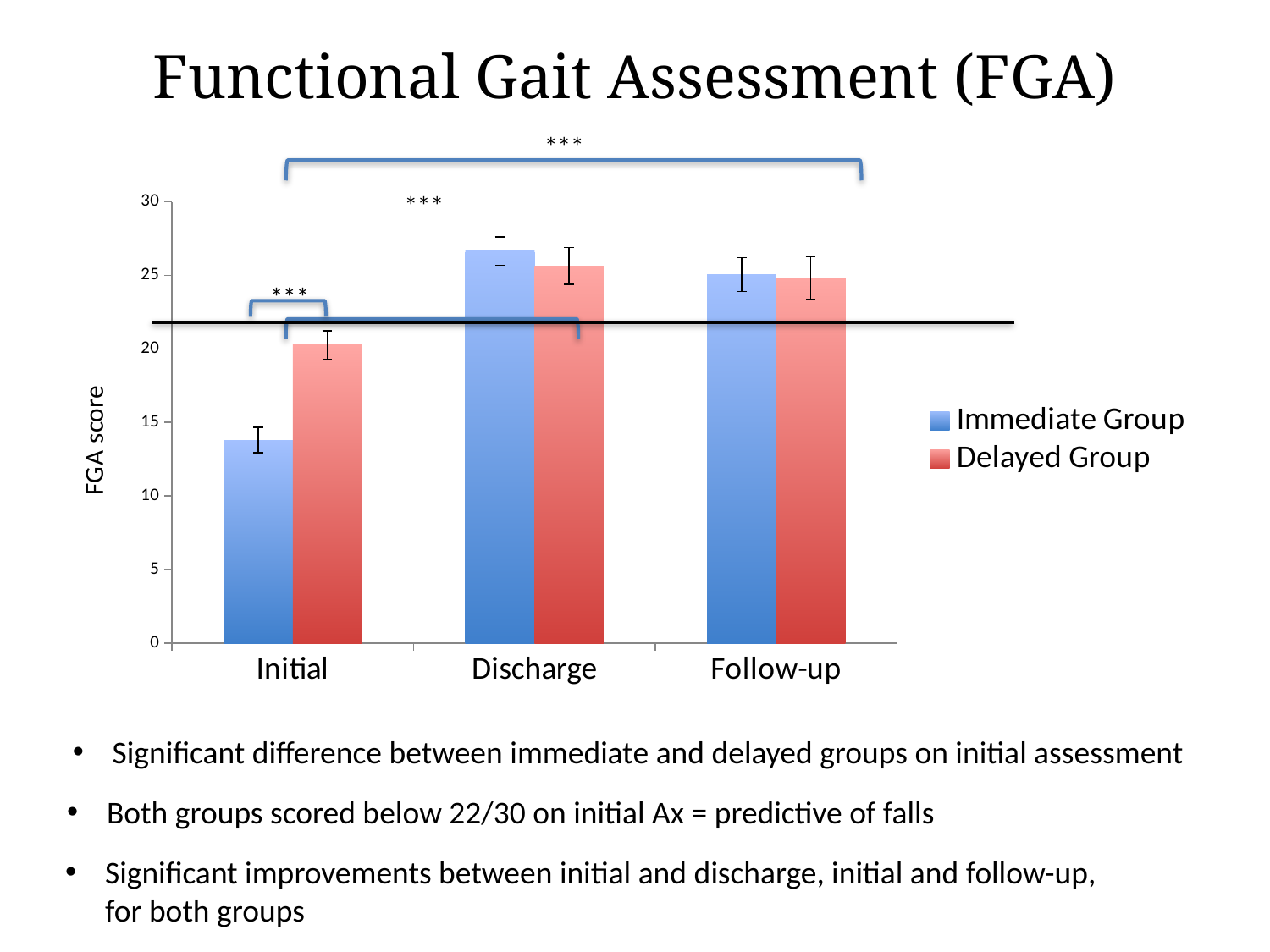
How many series does the legend list? 2 At which time point is the Immediate Group's FGA score lowest? Initial What kind of chart is shown on the slide? bar chart What is the label on the y axis? FGA score Which series is shown in blue? Immediate Group How many categories are shown on the x axis? 3 At which time point is the Immediate Group's FGA score highest? Discharge At Initial, which group has the higher FGA score, the Immediate Group or the Delayed Group? Delayed Group Is the value for the Immediate Group at Discharge greater or less than 25? greater Is the value for the Immediate Group at Initial greater or less than 15? less